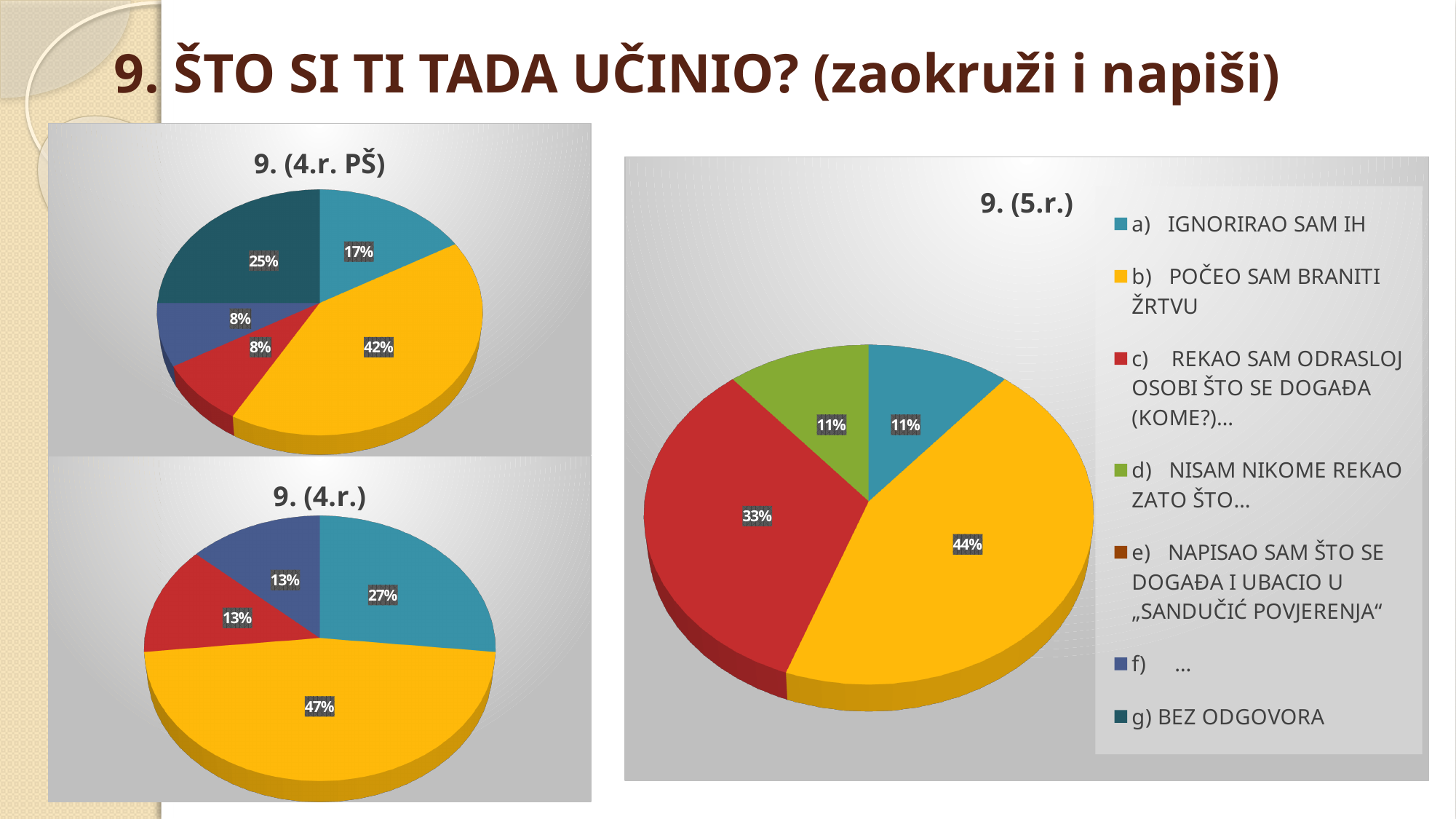
In the chart titled "9. (5.r.)", how many entries does the legend list? 7 In the chart titled "9. (4.r.)", what percentage is shown on the largest slice? 47% In the chart titled "9. (5.r.)", what share of the pie is labelled for "b) POČEO SAM BRANITI ŽRTVU"? 44% What type of chart is used for "9. (4.r.)"? pie chart In the chart titled "9. (5.r.)", how many slices does the pie have? 4 In the chart titled "9. (5.r.)", what is the difference between the 44% slice and the 33% slice? 11% In the chart titled "9. (4.r. PŠ)", how many slices does the pie have? 5 In the chart titled "9. (4.r. PŠ)", what percentage is shown on the yellow slice? 42% In the chart titled "9. (4.r.)", which is larger: the teal slice or the red slice? the teal slice In the chart titled "9. (5.r.)", which category has the largest slice? b) POČEO SAM BRANITI ŽRTVU In the chart titled "9. (4.r. PŠ)", what percentage is shown on the dark teal slice? 25% In the chart titled "9. (5.r.)", what percentage is shown for "c) REKAO SAM ODRASLOJ OSOBI ŠTO SE DOGAĐA (KOME?)..."? 33%